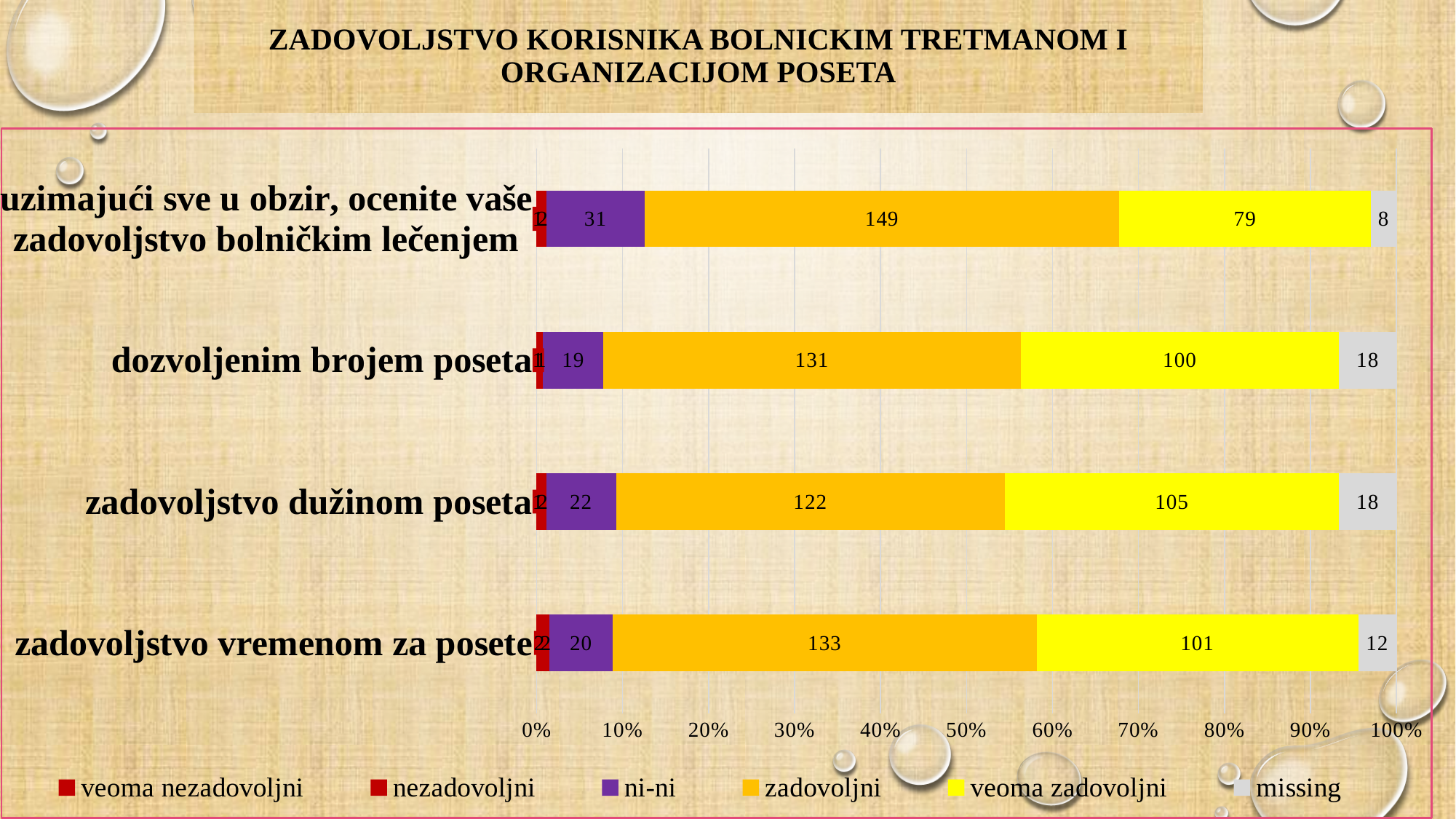
What is the 'missing' value for 'uzimajući sve u obzir, ocenite vaše zadovoljstvo bolničkim lečenjem'? 8 Which category has the highest 'zadovoljni' value? uzimajući sve u obzir, ocenite vaše zadovoljstvo bolničkim lečenjem What colour represents the 'veoma zadovoljni' series in the legend? yellow How many series does the legend list? 6 What is the difference between the 'zadovoljni' values for 'zadovoljstvo vremenom za posete' and 'zadovoljstvo dužinom poseta'? 11 Which category has the lowest 'veoma zadovoljni' value? uzimajući sve u obzir, ocenite vaše zadovoljstvo bolničkim lečenjem Which is larger: the 'ni-ni' value for 'dozvoljenim brojem poseta' or for 'zadovoljstvo dužinom poseta'? zadovoljstvo dužinom poseta What is the 'zadovoljni' value for 'dozvoljenim brojem poseta'? 131 What kind of chart is shown on the slide? stacked bar chart What is the 'ni-ni' value for 'zadovoljstvo vremenom za posete'? 20 What is the 'veoma zadovoljni' value for 'zadovoljstvo dužinom poseta'? 105 How many categories are plotted on the chart? 4